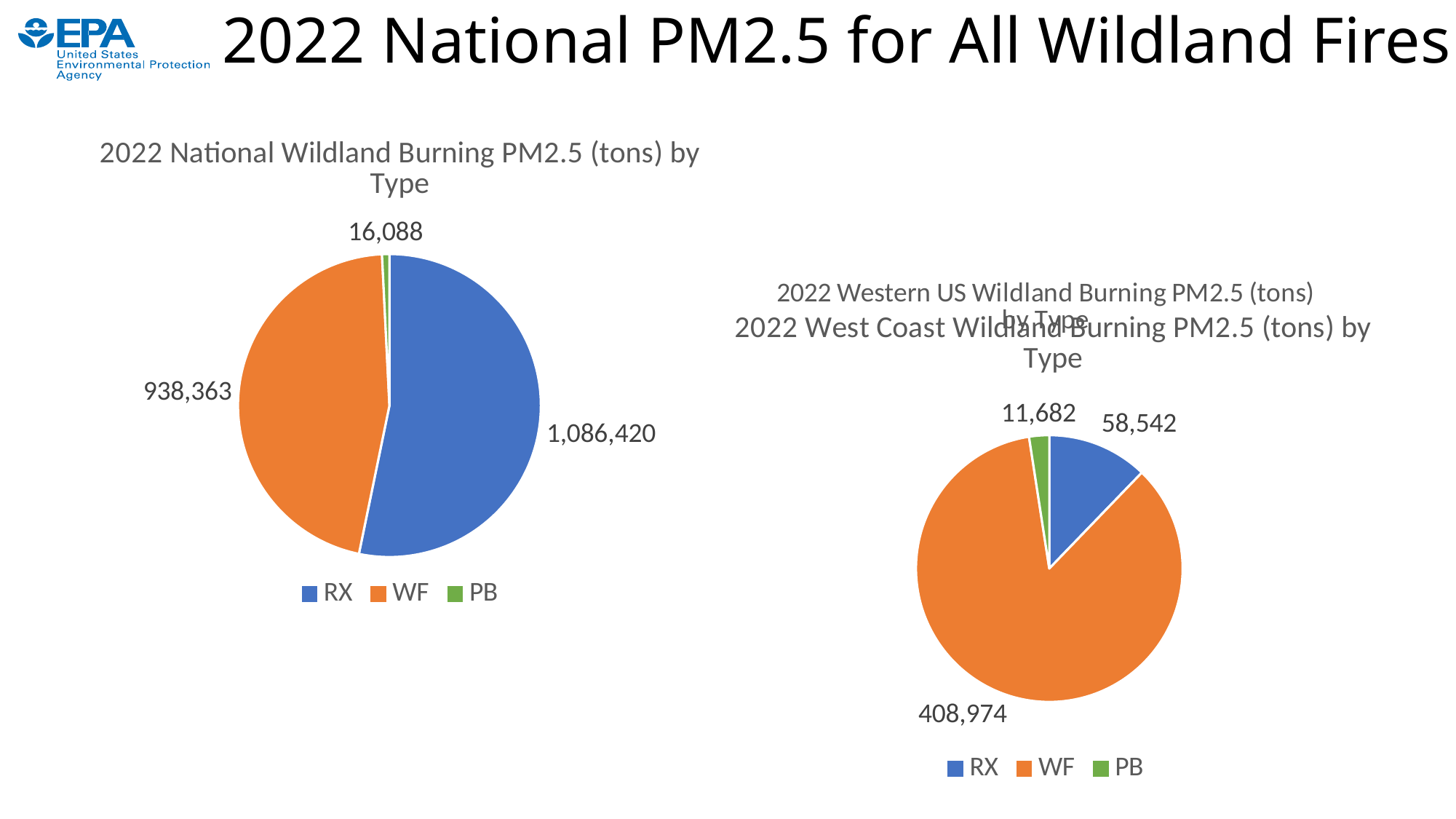
In the left pie chart (2022 National Wildland Burning PM2.5 by Type), what is the difference between the RX and WF values? 148,057 In the right pie chart, what is the value for WF? 408,974 In the right pie chart, what is the value for RX? 58,542 In the left pie chart (2022 National Wildland Burning PM2.5 by Type), what is the value for RX? 1,086,420 In the left pie chart (2022 National Wildland Burning PM2.5 by Type), what is the value for PB? 16,088 How many series does the legend of the left pie chart list? 3 In the right pie chart, which is larger, WF or RX? WF What kind of chart is used on the left side of the slide? Pie chart In the right pie chart, what is the value for PB? 11,682 In the left pie chart (2022 National Wildland Burning PM2.5 by Type), which type has the largest value? RX In the left pie chart (2022 National Wildland Burning PM2.5 by Type), what is the value for WF? 938,363 In the right pie chart, which type has the smallest value? PB